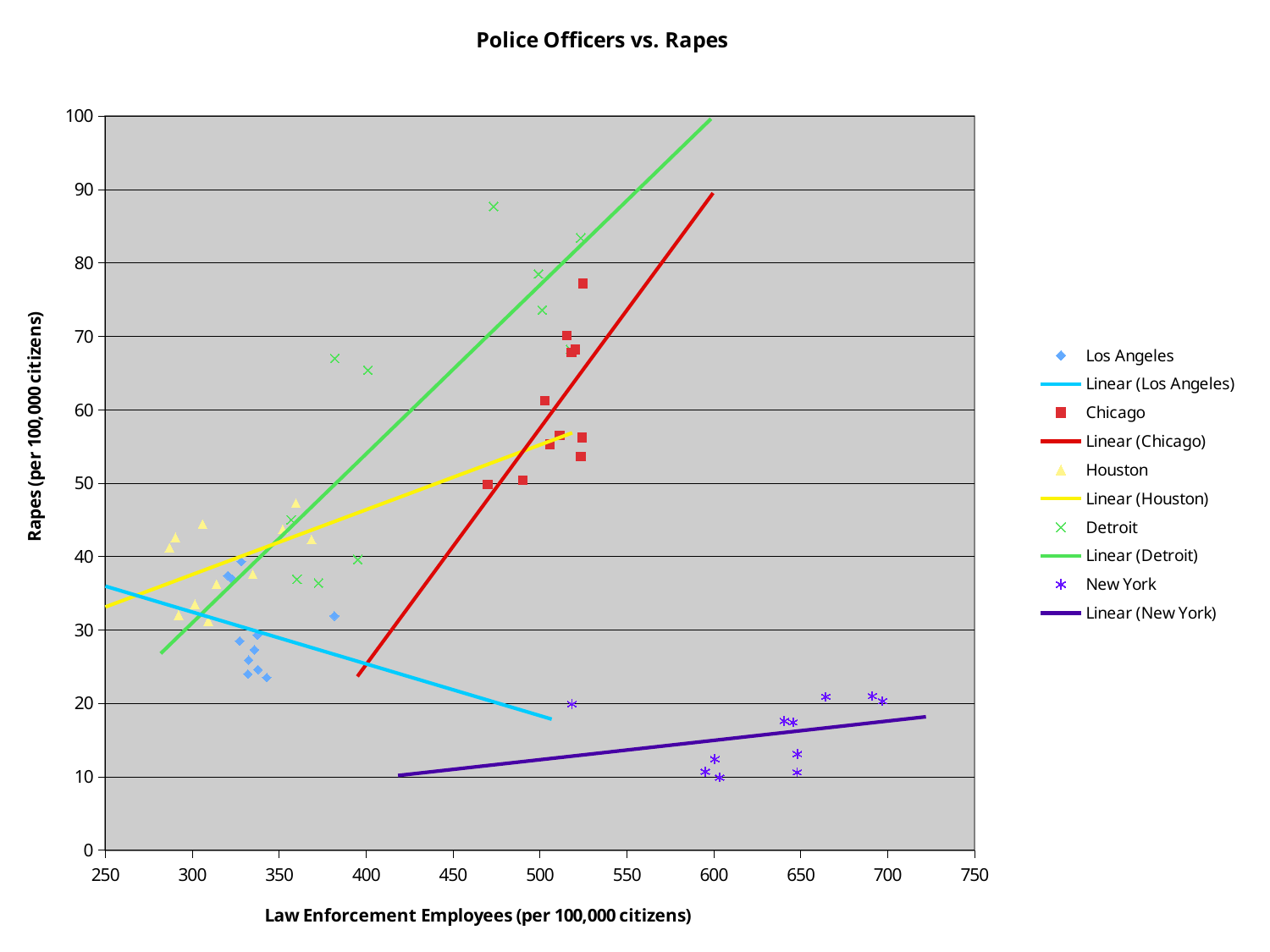
Which city has the data points with the lowest rapes per 100,000 citizens? New York Which city has the data point with the highest rapes per 100,000 citizens? Detroit How many entries does the chart's legend list? 10 Which city has the data points with the highest law enforcement employees per 100,000 citizens? New York Is the highest Detroit data point greater or less than 80 rapes per 100,000 citizens? greater What is the title of the chart? Police Officers vs. Rapes Does the Linear (Los Angeles) trend line rise or fall as law enforcement employees increase? Fall Are the rape values for the New York data points greater or less than 30? less What kind of chart is shown on the slide? Scatter chart Does the Linear (New York) trend line rise or fall along the x axis? Rise Does the Linear (Detroit) trend line rise or fall as law enforcement employees increase? Rise What is the label of the vertical axis? Rapes (per 100,000 citizens)